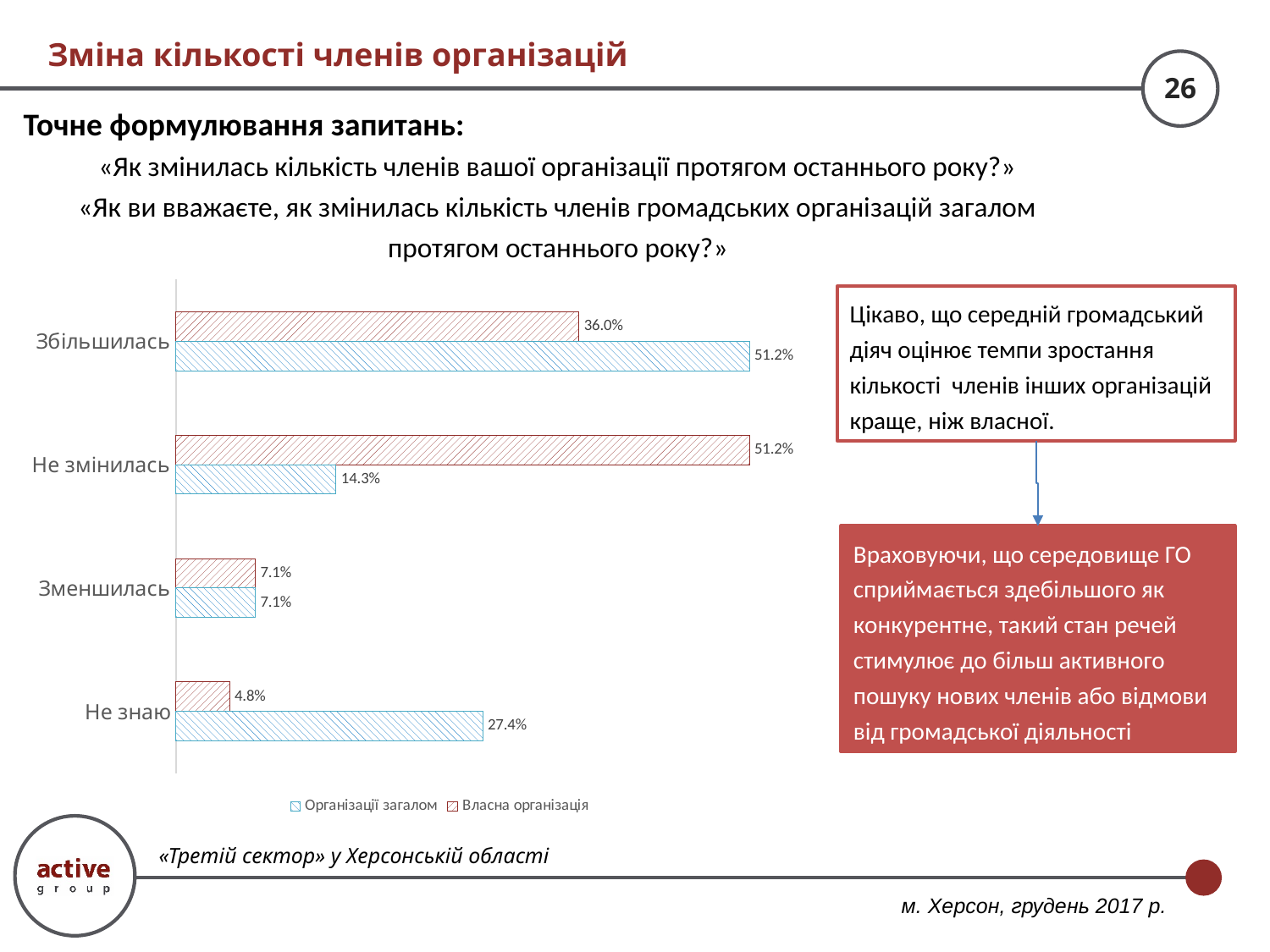
What is the value for "Власна організація" in the "Не знаю" category? 4.8% Which category has the lowest value for the "Організації загалом" series? Зменшилась What type of chart is shown on the slide? bar chart How many series does the chart legend list? 2 What is the difference between "Організації загалом" and "Власна організація" in the "Не знаю" category? 22.6% How many categories are shown on the chart? 4 In the "Не змінилась" category, which series has the larger value: "Організації загалом" or "Власна організація"? Власна організація What is the value for "Власна організація" in the "Збільшилась" category? 36.0% What is the value for "Організації загалом" in the "Збільшилась" category? 51.2% What is the value for "Організації загалом" in the "Не змінилась" category? 14.3% Which category has the highest value for the "Власна організація" series? Не змінилась Which series is shown with red hatched bars in the legend? Власна організація